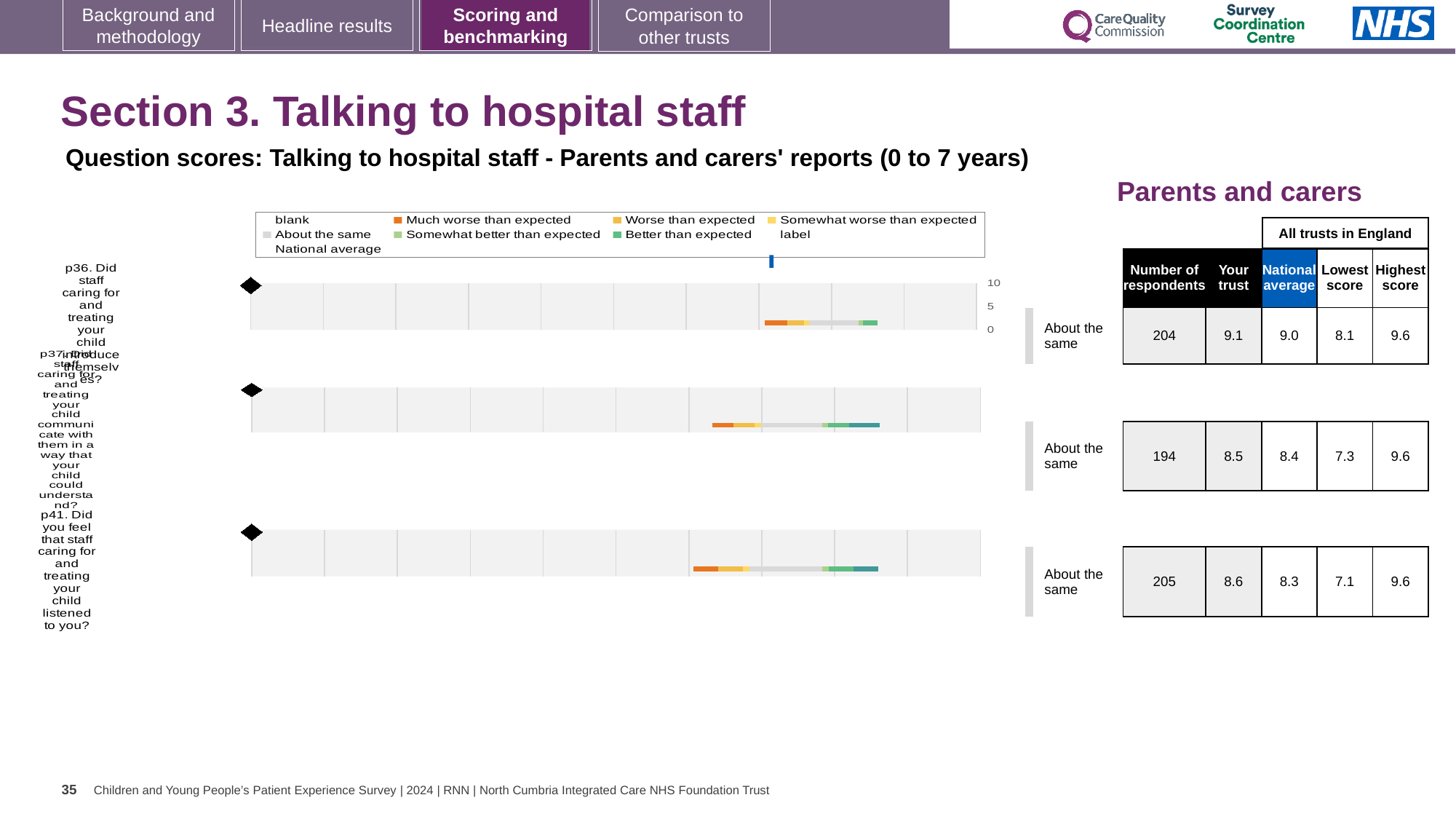
Which question row has the lowest number of respondents? p37 For the p36 chart row, what is the 'Your trust' score shown in the table? 9.1 Which question row has the highest 'Your trust' score? p36 For the p37 chart row, how many respondents are shown? 194 For the p37 chart row, what is the lowest score among all trusts in England? 7.3 What colour in the legend represents 'Much worse than expected'? orange What kind of chart is used for the three question rows on the slide? bar chart What is the highest tick value shown on the chart axis? 10 How many question rows (charts) are shown on the slide? 3 Which has the larger 'Your trust' score, the p37 row or the p41 row? p41 For the p41 chart row, what is the national average score? 8.3 For the p41 row, what is the difference between the highest score and the lowest score? 2.5